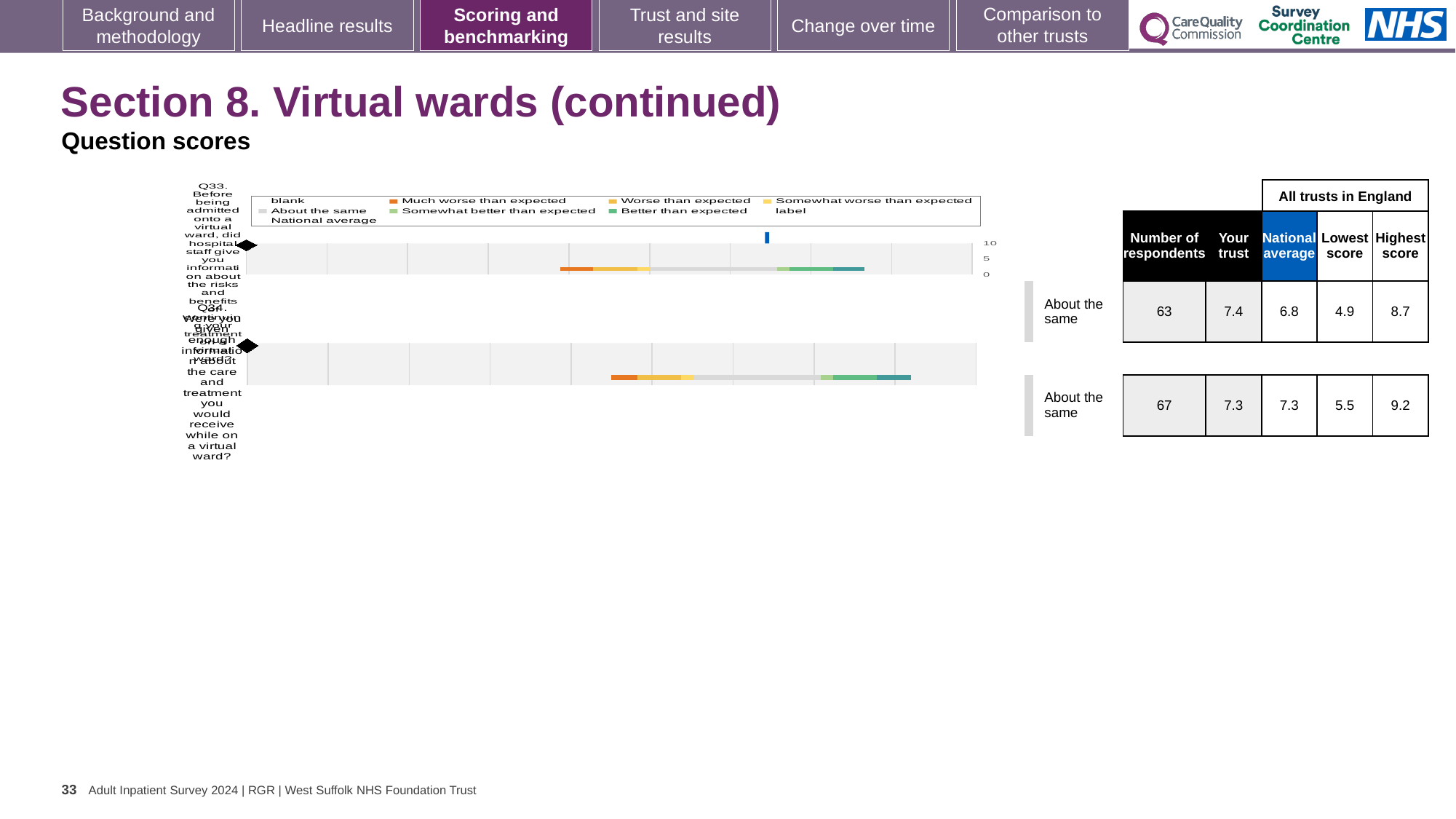
What benchmark category is shown next to the Q33 bar? About the same What is the lowest score among all trusts in England for Q33? 4.9 Which question has the higher number of respondents, Q33 or Q34? Q34 What is the 'Your trust' score for Q33? 7.4 What is the highest score among all trusts in England for Q34? 9.2 What is the difference between the 'Your trust' score and the national average for Q33? 0.6 Which legend entry is shown in orange? Much worse than expected What kind of chart is shown on the slide? Bar chart What is the number of respondents for Q33? 63 How many questions (categories) are plotted in the chart? 2 What is the national average score for Q34? 7.3 For Q33, which is larger: the 'Your trust' score or the national average? Your trust